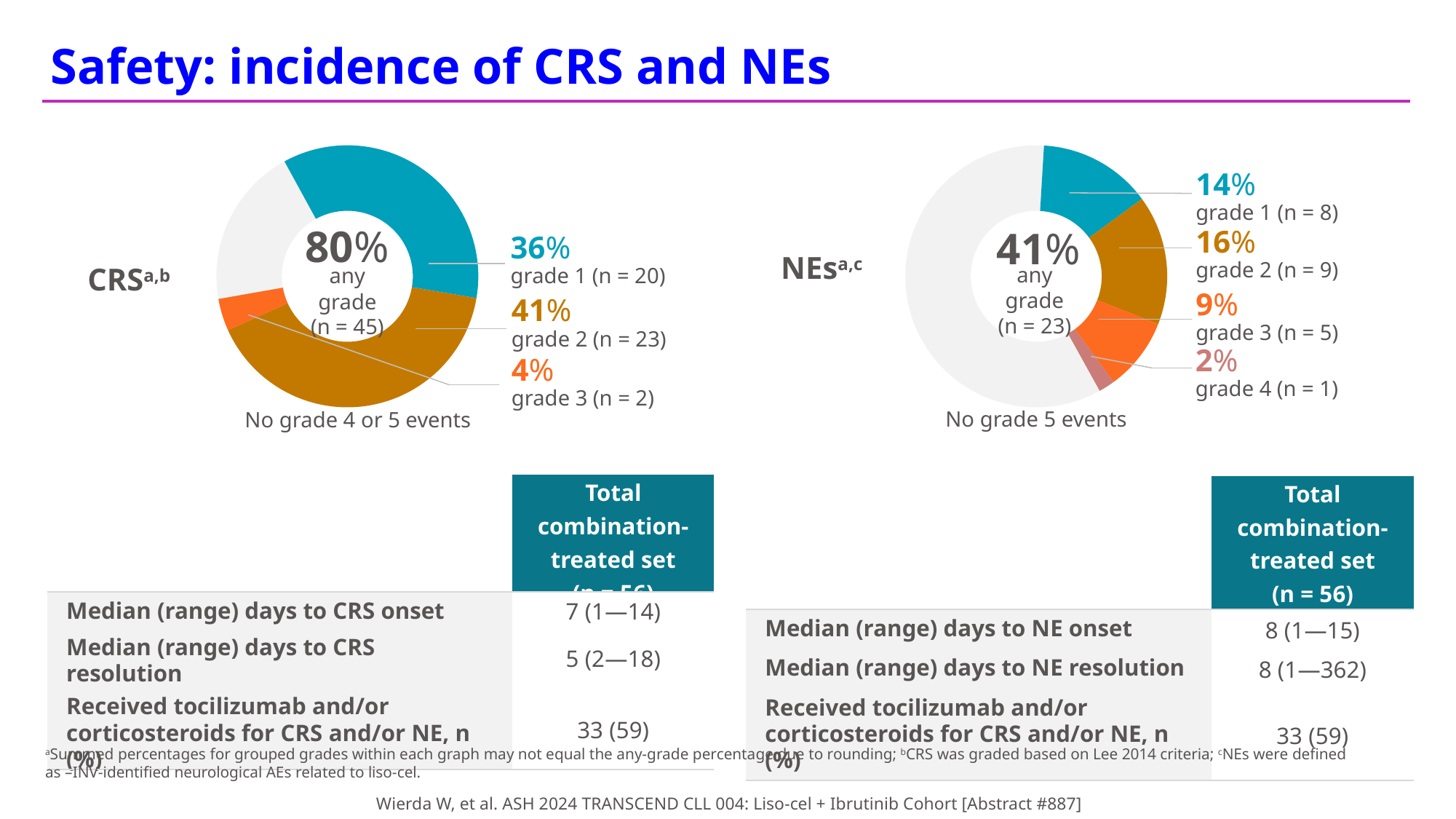
According to the note under the CRS chart, which grades had no events? Grade 4 or 5 In the CRS chart, what is the any-grade CRS percentage shown in the centre of the donut? 80% In the NEs chart, what percentage of patients had grade 4 NEs? 2% What kind of chart is used to show the incidence of CRS? Donut (pie) chart How many grade categories are labelled in the NEs chart? 4 In the CRS chart, which grade has the highest percentage? grade 2 In the NEs chart, what is the difference in percentage points between grade 2 and grade 3 NEs? 7 In the NEs chart, which grade has the lowest percentage? grade 4 Which is larger: the any-grade percentage in the CRS chart or the any-grade percentage in the NEs chart? CRS In the CRS chart, what is the difference in percentage points between grade 2 and grade 1 CRS? 5 In the NEs chart, how many patients had grade 3 NEs? n = 5 In the CRS chart, what percentage of patients had grade 2 CRS? 41%